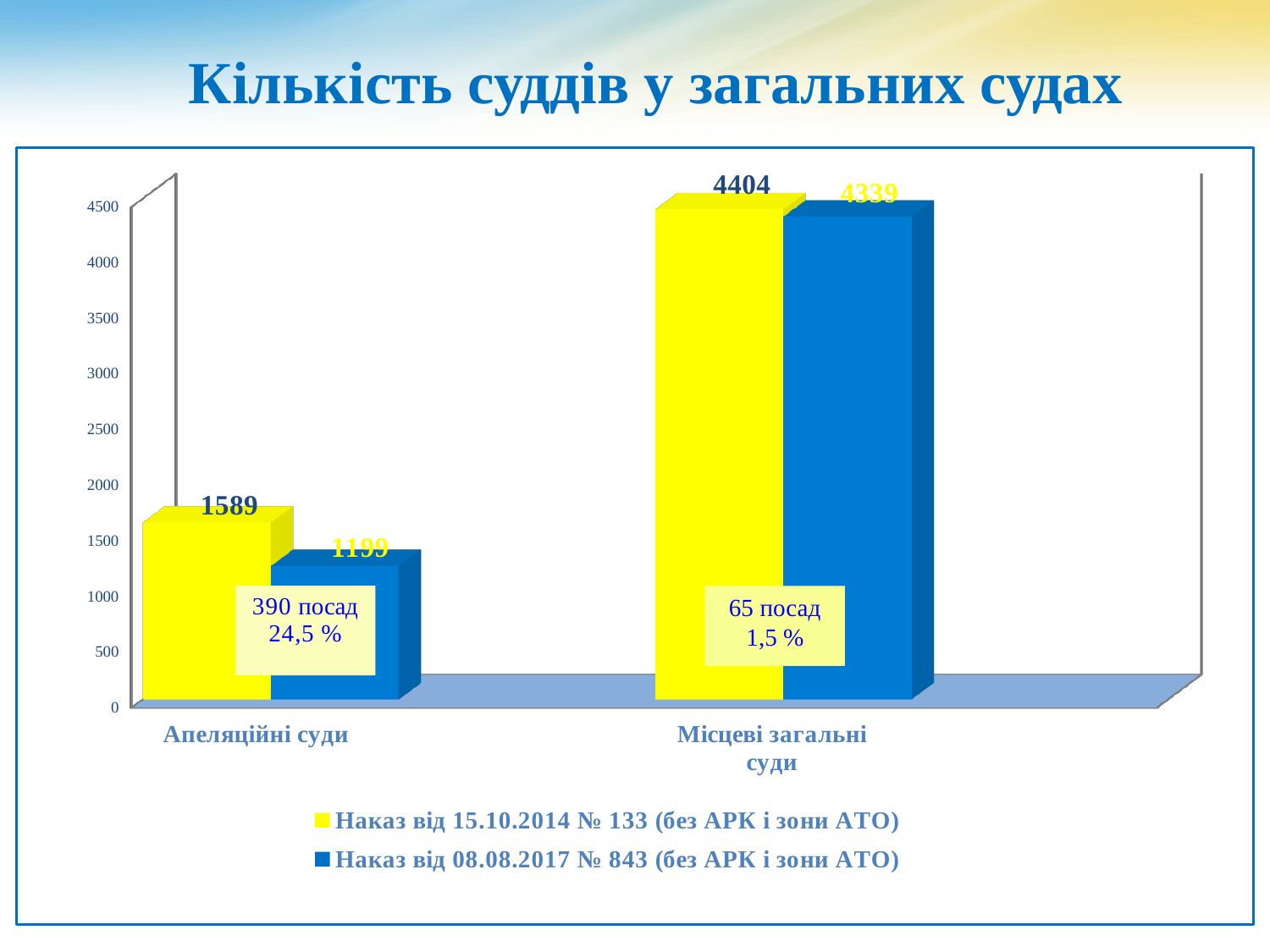
Which is larger for Апеляційні суди: the value for Наказ від 15.10.2014 № 133 or for Наказ від 08.08.2017 № 843? Наказ від 15.10.2014 № 133 What is the value for Апеляційні суди in the series Наказ від 08.08.2017 № 843? 1199 What is the value for Місцеві загальні суди in the series Наказ від 15.10.2014 № 133? 4404 What is the difference between the two values for Місцеві загальні суди? 65 What is the value for Апеляційні суди in the series Наказ від 15.10.2014 № 133? 1589 Which category has the highest value in the series Наказ від 15.10.2014 № 133? Місцеві загальні суди How many categories are shown on the x axis? 2 What type of chart is shown on the slide? bar chart How many series does the legend list? 2 What is the value for Місцеві загальні суди in the series Наказ від 08.08.2017 № 843? 4339 What is the difference between the two values for Апеляційні суди? 390 What is the title of the chart? Кількість суддів у загальних судах